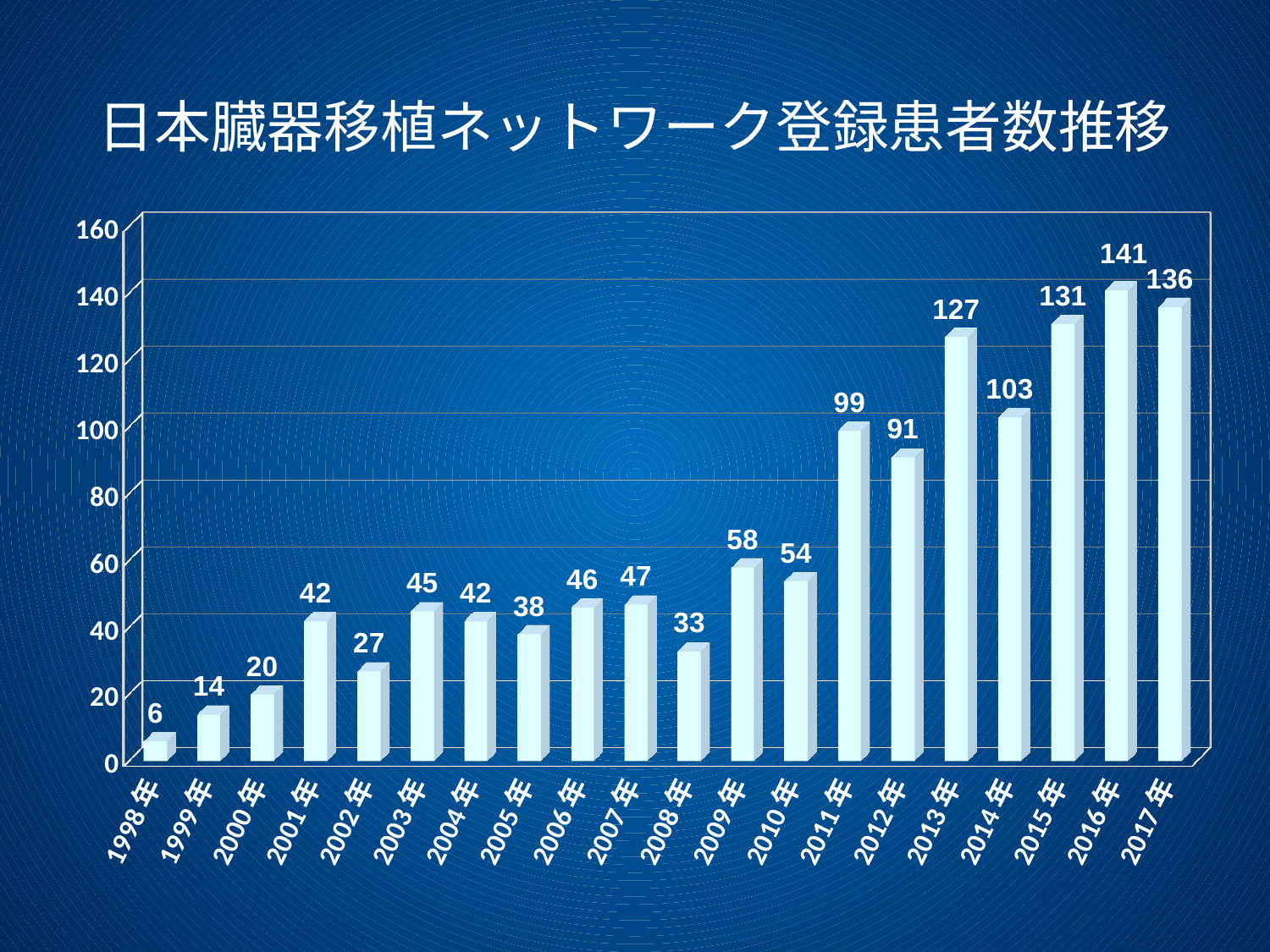
What is the value for 2008年? 33 What kind of chart is shown on the slide? bar chart Is the value for 2015年 greater or less than 120? greater Which year has the lowest value? 1998年 What is the value for 2013年? 127 Which year has the highest value? 2016年 What is the difference between the values for 2011年 and 2010年? 45 How many years are shown on the x axis? 20 Which is larger, the value for 2012年 or the value for 2014年? 2014年 What is the difference between the values for 2016年 and 2017年? 5 What is the value for 1998年? 6 What is the title of the chart? 日本臓器移植ネットワーク登録患者数推移